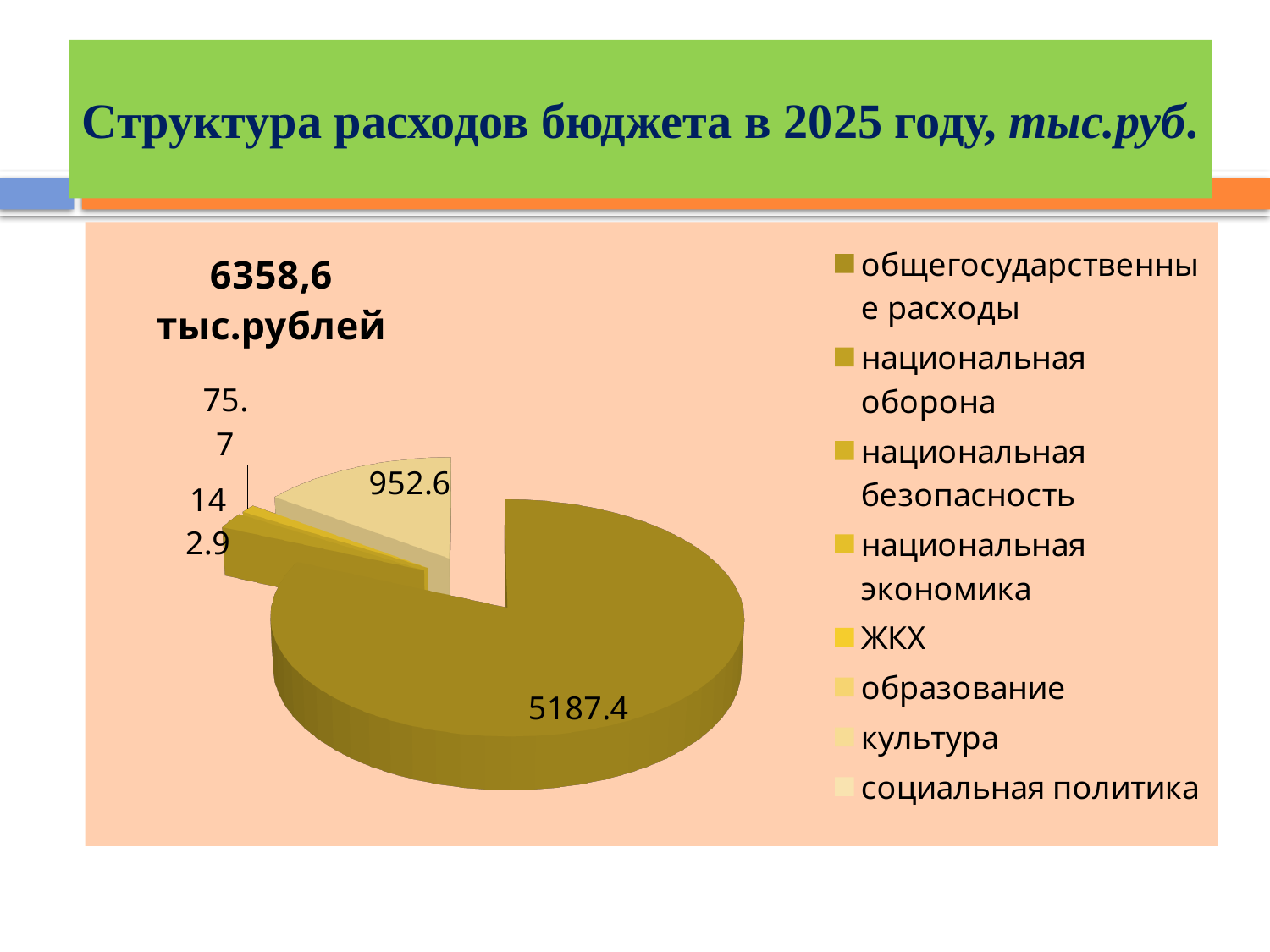
What is the value of the largest slice of the pie chart? 5187.4 What value is shown for общегосударственные расходы? 5187.4 What total amount is printed above the pie chart? 6358,6 тыс.рублей What is the difference between the slice labelled 5187.4 and the slice labelled 952.6? 4234.8 What is the title of the slide containing the pie chart? Структура расходов бюджета в 2025 году, тыс.руб. Which category has the largest slice in the pie chart? общегосударственные расходы What is the smallest data label shown on the pie chart? 75.7 Which is larger, the slice labelled 952.6 or the slice labelled 5187.4? 5187.4 What kind of chart is shown on the slide? pie chart How many categories does the legend of the pie chart list? 8